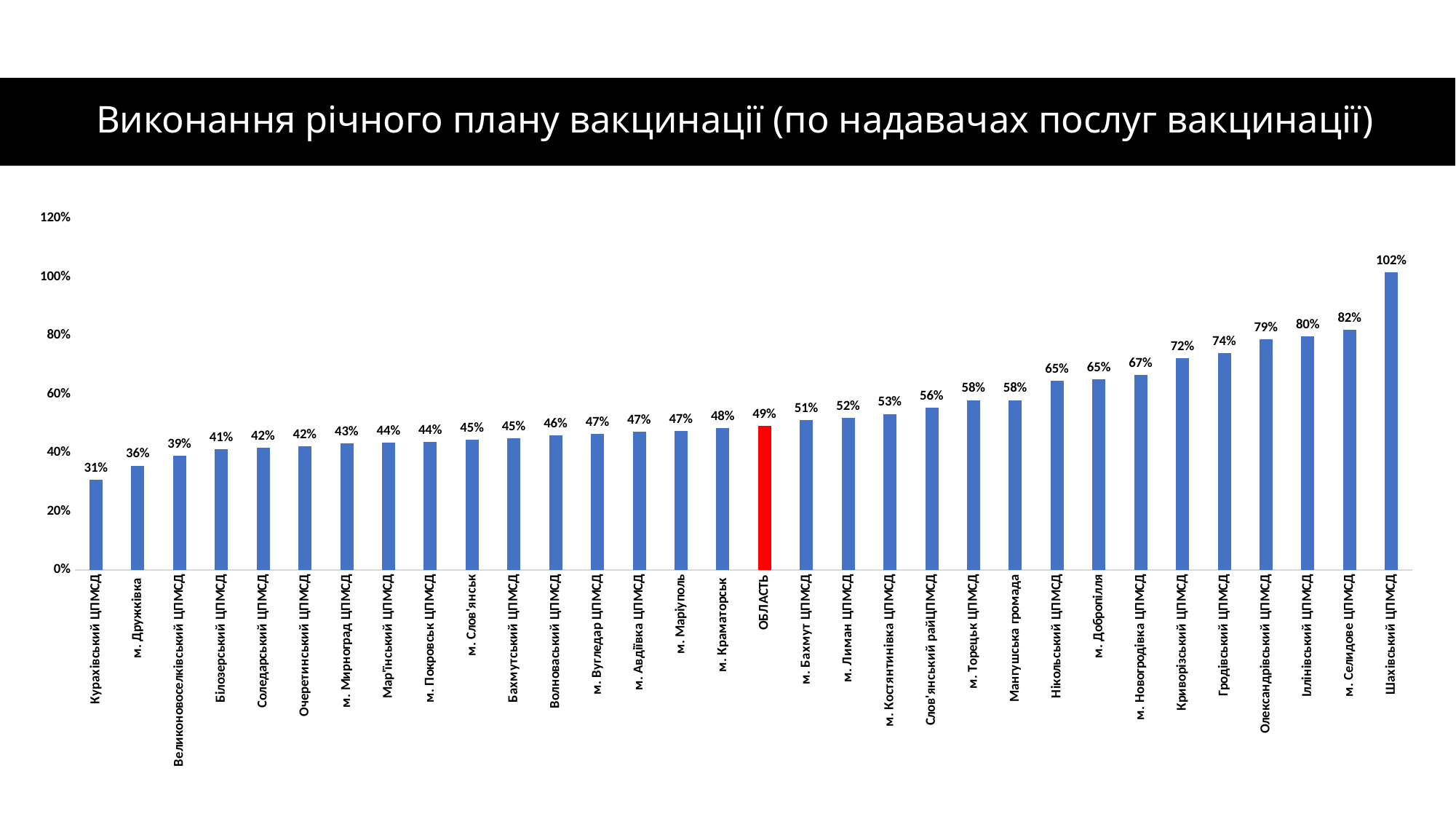
Which category has the highest value? Шахівський ЦПМСД What is the value for Шахівський ЦПМСД? 102% How many bars are shown in the chart? 32 What is the value for Криворізький ЦПМСД? 72% What is the difference between the values for Шахівський ЦПМСД and Курахівський ЦПМСД? 71% Which category has the lowest value? Курахівський ЦПМСД What is the value for ОБЛАСТЬ? 49% What kind of chart is shown on the slide? bar chart Which bar is coloured red instead of blue? ОБЛАСТЬ What is the value for м. Краматорськ? 48% Which is larger, the value for м. Селидове ЦПМСД or the value for Гродівський ЦПМСД? м. Селидове ЦПМСД Is the value for м. Дружківка greater or less than 40%? less